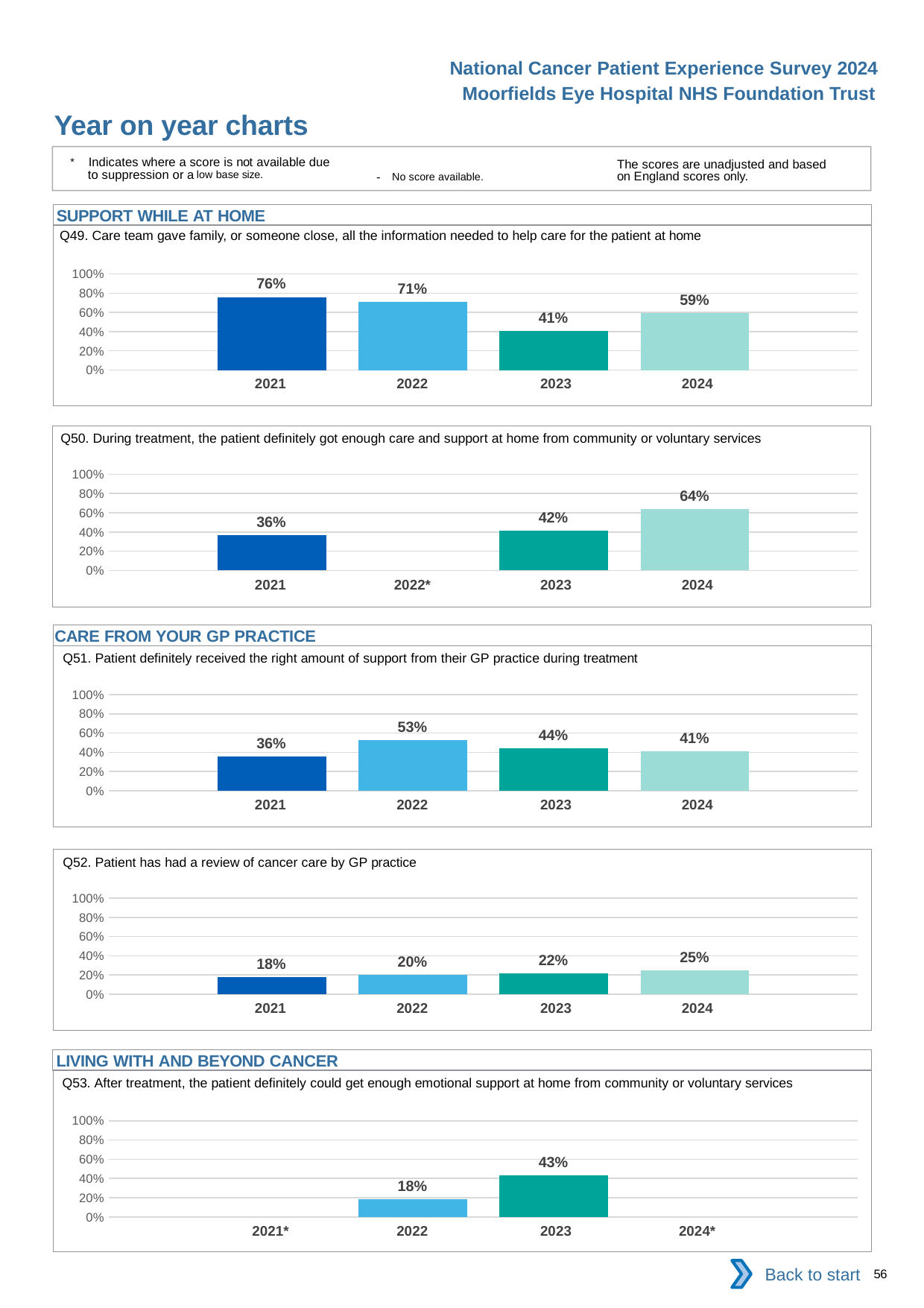
What kind of chart is the Q49 chart? bar chart In the Q50 chart, which year has no score available due to suppression or a low base size? 2022 In the Q53 chart, what is the difference between the 2023 and 2022 values? 25% In the Q53 chart, how many years have a bar plotted? 2 In the Q49 chart, which year has the lowest value? 2023 In the Q52 chart, do the values rise or fall from 2021 to 2024? rise In the Q51 chart, which year has the highest value? 2022 In the Q51 chart, is the value for 2023 larger or smaller than the value for 2024? larger In the Q50 chart, what is the difference between the 2024 and 2021 values? 28% In the Q52 chart, what is the value for 2023? 22% In the Q50 chart, what is the value for 2024? 64% In the Q49 chart, what is the value for 2021? 76%